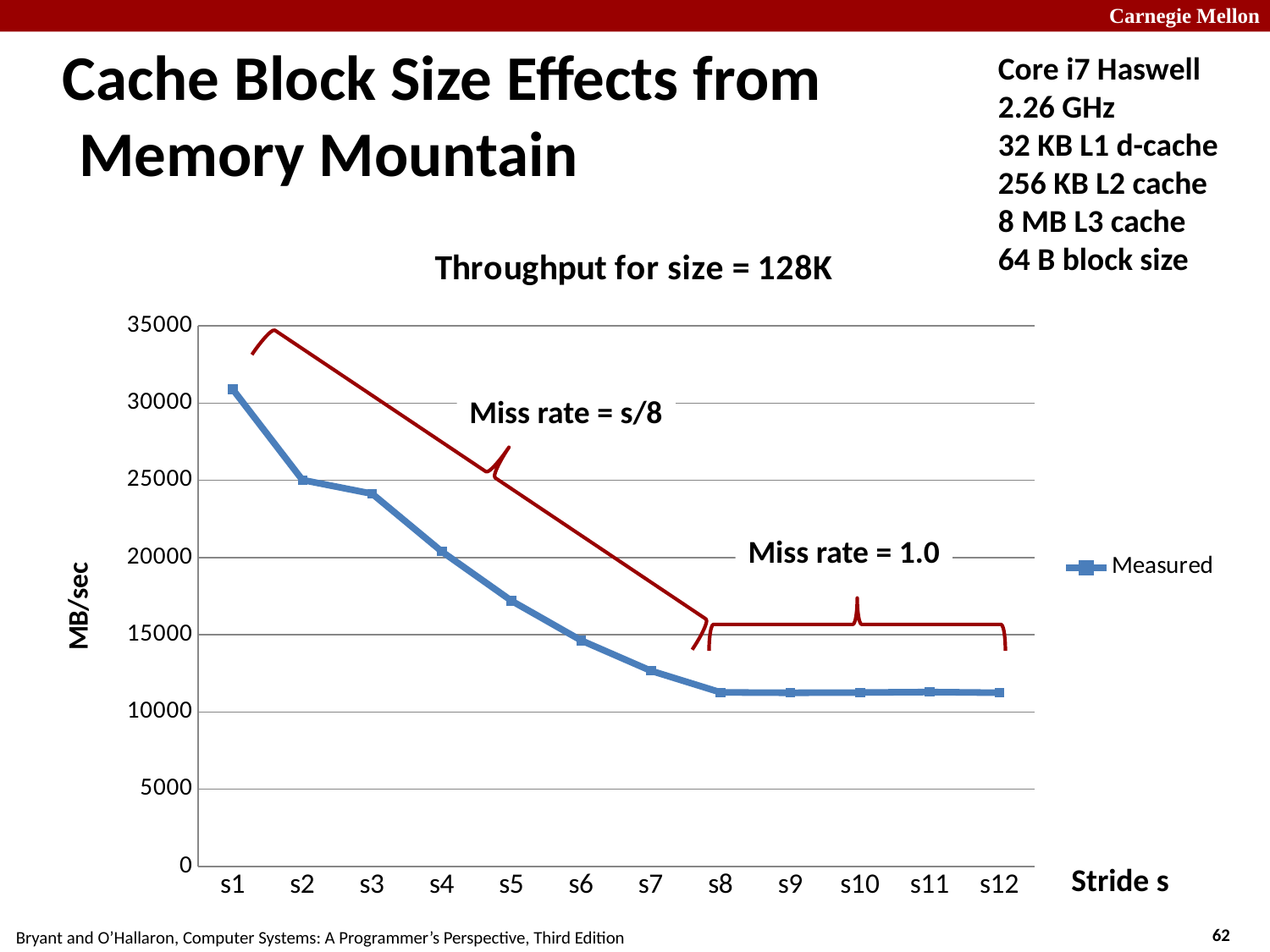
Is the value for s12 greater or less than 10000? greater Is the value for s5 greater or less than 20000? less What is the title of the chart? Throughput for size = 128K Is the value for s1 greater or less than 30000? greater How many series does the legend list? 1 Do the measured values rise or fall as the stride increases from s1 to s8? fall How many stride values are plotted along the x axis? 12 What kind of chart is shown on the slide? line chart Which has the larger throughput, s3 or s7? s3 Which stride has the highest measured throughput? s1